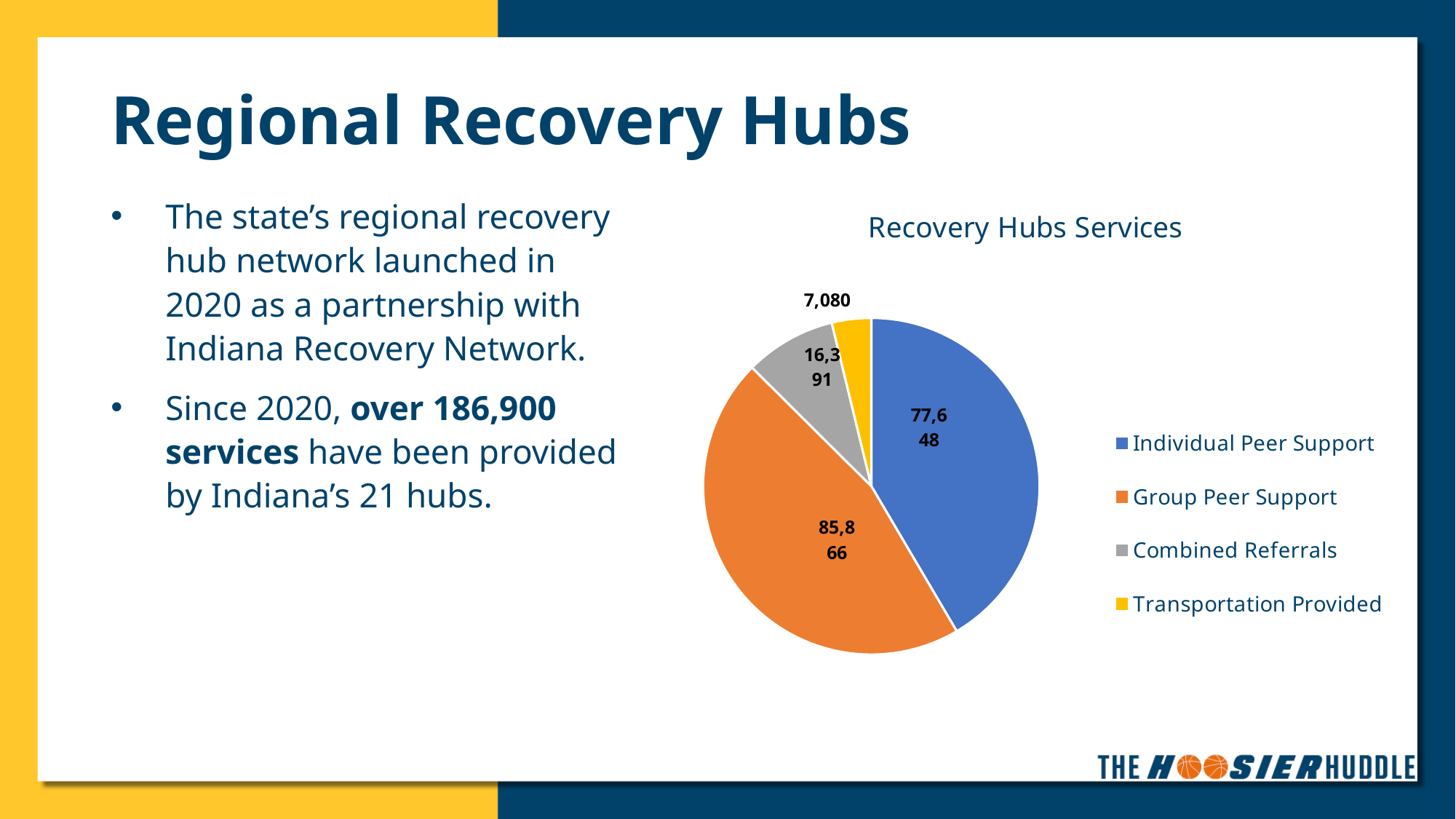
Which category has the smallest slice of the pie? Transportation Provided Which category has the largest slice of the pie? Group Peer Support What is the difference between Group Peer Support and Individual Peer Support? 8,218 Which colour represents Combined Referrals in the pie chart? Gray What is the value for Combined Referrals? 16,391 What is the value for Individual Peer Support? 77,648 Which is larger, Combined Referrals or Transportation Provided? Combined Referrals What is the value for Group Peer Support? 85,866 What is the title of the chart? Recovery Hubs Services How many categories does the pie chart show? 4 What type of chart is shown on the slide? Pie chart What is the value for Transportation Provided? 7,080